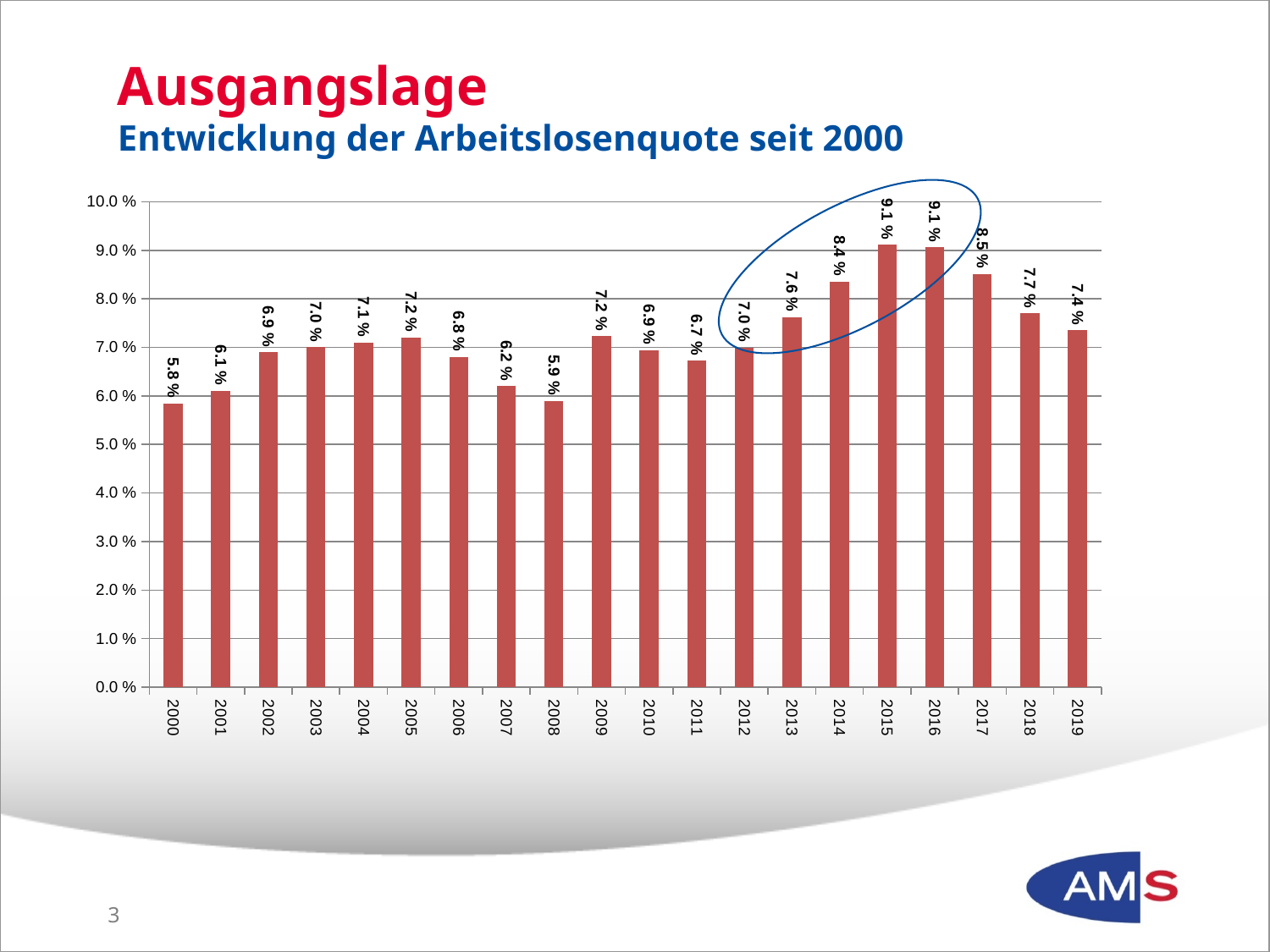
What is the difference between the values for 2016 and 2019? 1.7 % Is the value for 2007 greater or less than 7.0 %? less What type of chart is shown on the slide? bar chart Which years share the highest value in the chart? 2015 and 2016 What is the value shown for 2008? 5.9 % Which year has the lowest unemployment rate in the chart? 2000 What is the unemployment rate shown for 2000? 5.8 % Which year has the larger value, 2013 or 2017? 2017 Do the values rise or fall from 2016 to 2019? fall How many years (bars) are shown in the chart? 20 What is the value shown for 2019? 7.4 % What value is labelled on the bar for 2014? 8.4 %